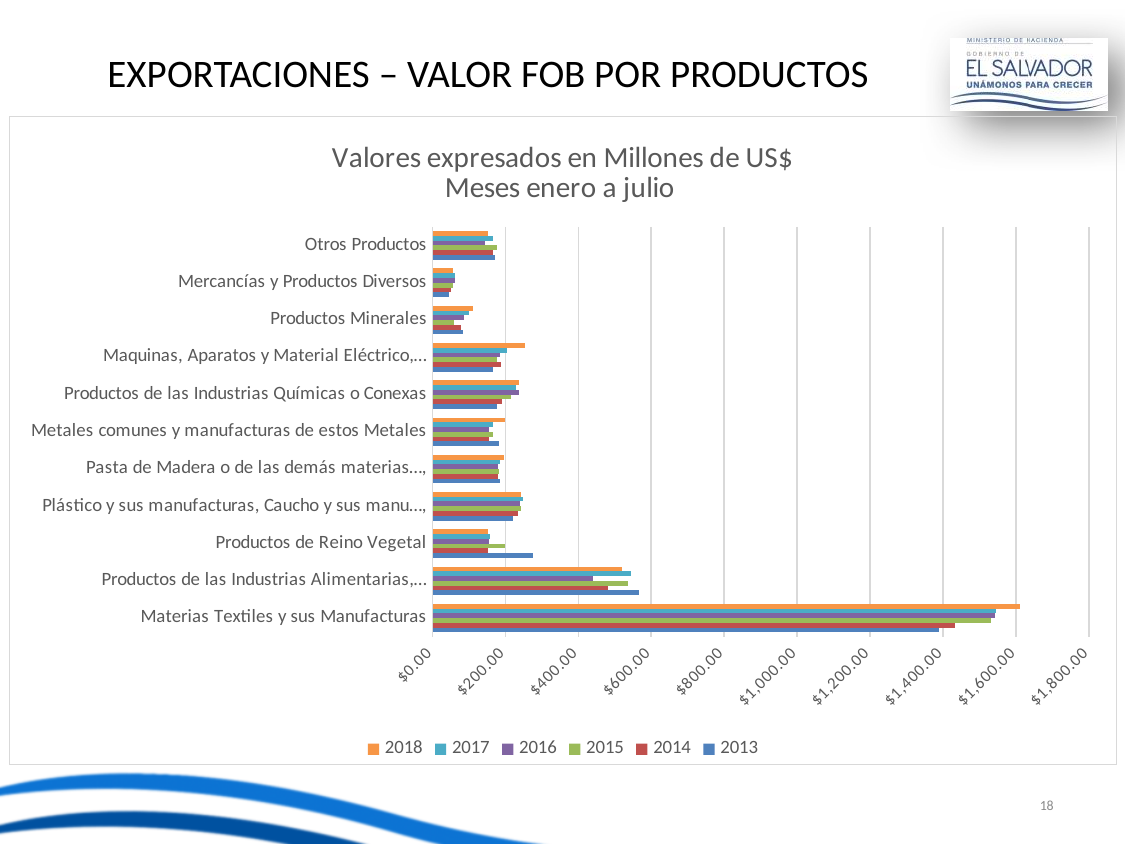
Is the 2018 value for Materias Textiles y sus Manufacturas greater or less than $1,400.00? greater Which product category has the highest export value in 2018? Materias Textiles y sus Manufacturas For 2018, which is larger: Materias Textiles y sus Manufacturas or Productos de las Industrias Alimentarias? Materias Textiles y sus Manufacturas What kind of chart is shown on the slide? Bar chart How many product categories are plotted on the chart? 11 Is the 2018 value for Productos de las Industrias Alimentarias greater or less than $400.00? greater Which year is listed first in the chart legend? 2018 For Productos de Reino Vegetal, which year has the larger value: 2013 or 2018? 2013 How many series does the legend list? 6 Is the 2013 value for Materias Textiles y sus Manufacturas greater or less than $1,000.00? greater Which product category has the lowest export value in 2018? Mercancías y Productos Diversos